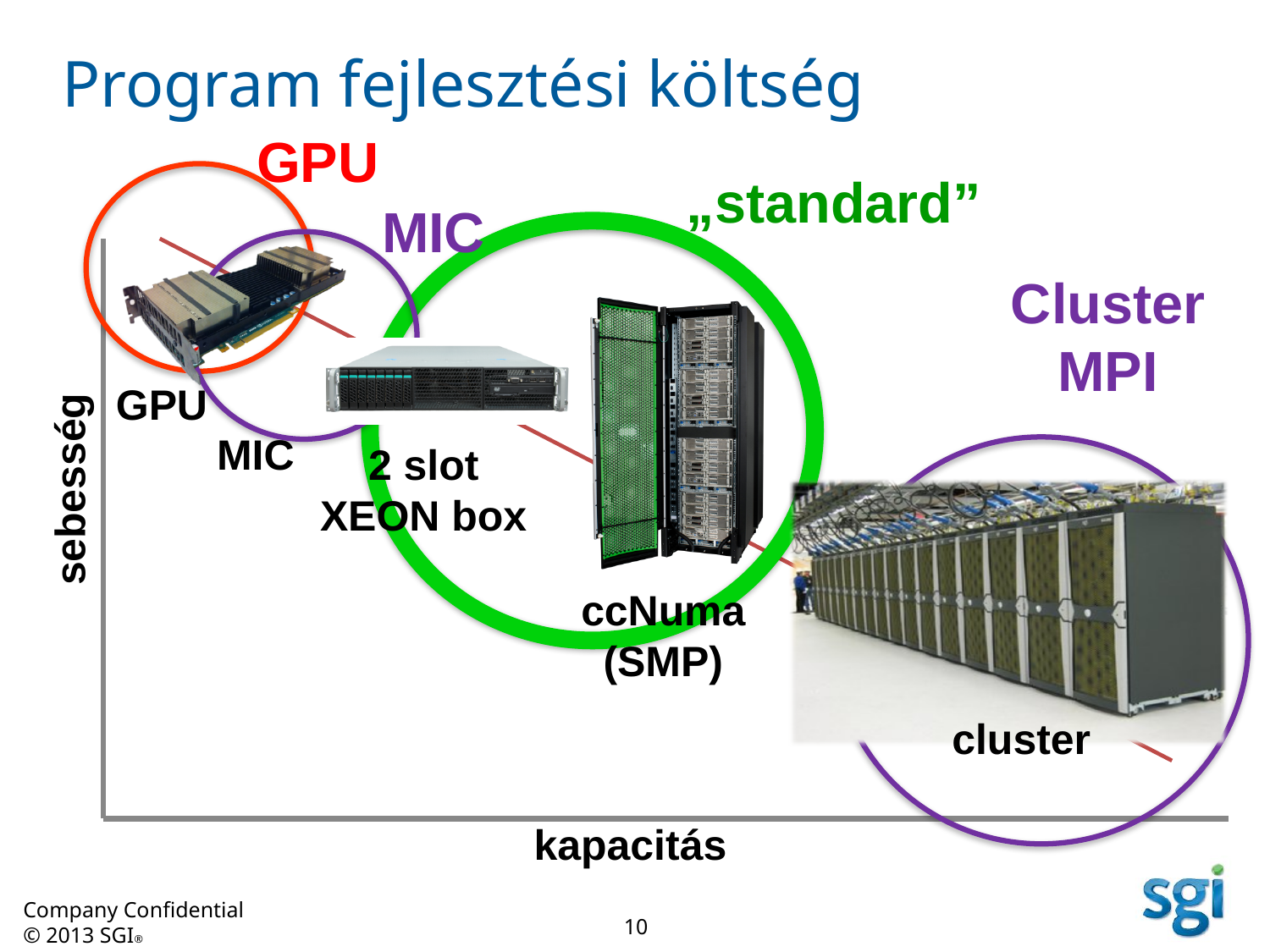
Which category is positioned highest on the sebesség axis? GPU Which category is positioned further right on the kapacitás axis, GPU or cluster? cluster What is the label on the horizontal axis of the diagram? kapacitás As kapacitás increases along the horizontal axis, does sebesség rise or fall? fall Which category is positioned lowest on the sebesség axis? cluster Which is positioned higher on the sebesség axis, 2 slot XEON box or ccNuma (SMP)? 2 slot XEON box What is the label on the vertical axis of the diagram? sebesség How many hardware categories are placed along the diagram (GPU, MIC, 2 slot XEON box, ccNuma (SMP), cluster)? 5